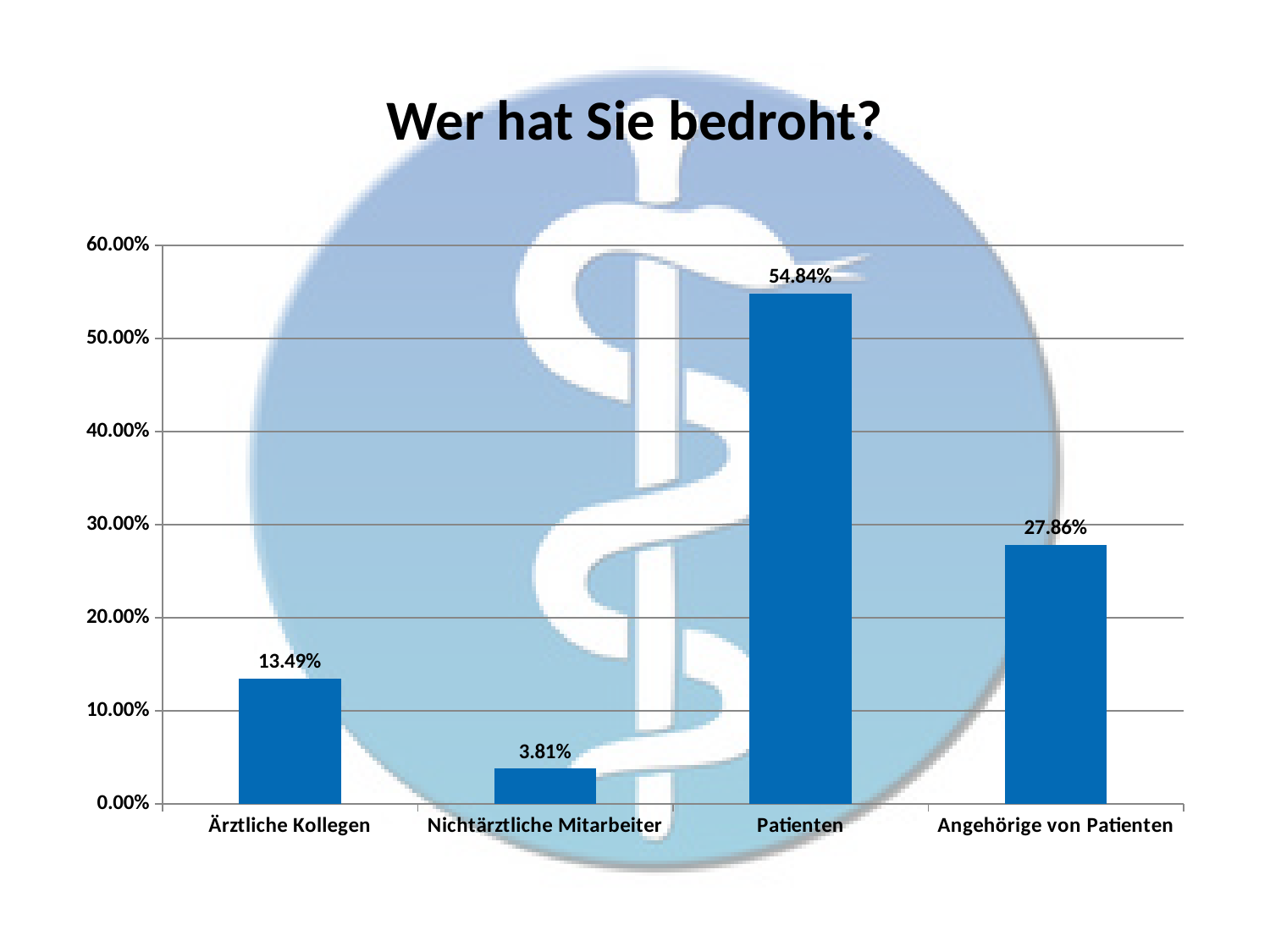
What kind of chart is shown on the slide? Bar chart Is the value for Patienten greater or less than 50.00%? greater What is the difference between the values for Ärztliche Kollegen and Nichtärztliche Mitarbeiter? 9.68% Which category has the highest value? Patienten What is the value for Angehörige von Patienten? 27.86% What is the value for Nichtärztliche Mitarbeiter? 3.81% What is the difference between the values for Patienten and Angehörige von Patienten? 26.98% Which is larger, the value for Ärztliche Kollegen or the value for Angehörige von Patienten? Angehörige von Patienten How many categories are shown on the x axis? 4 What is the value for Ärztliche Kollegen? 13.49% Which category has the lowest value? Nichtärztliche Mitarbeiter What is the value for Patienten? 54.84%